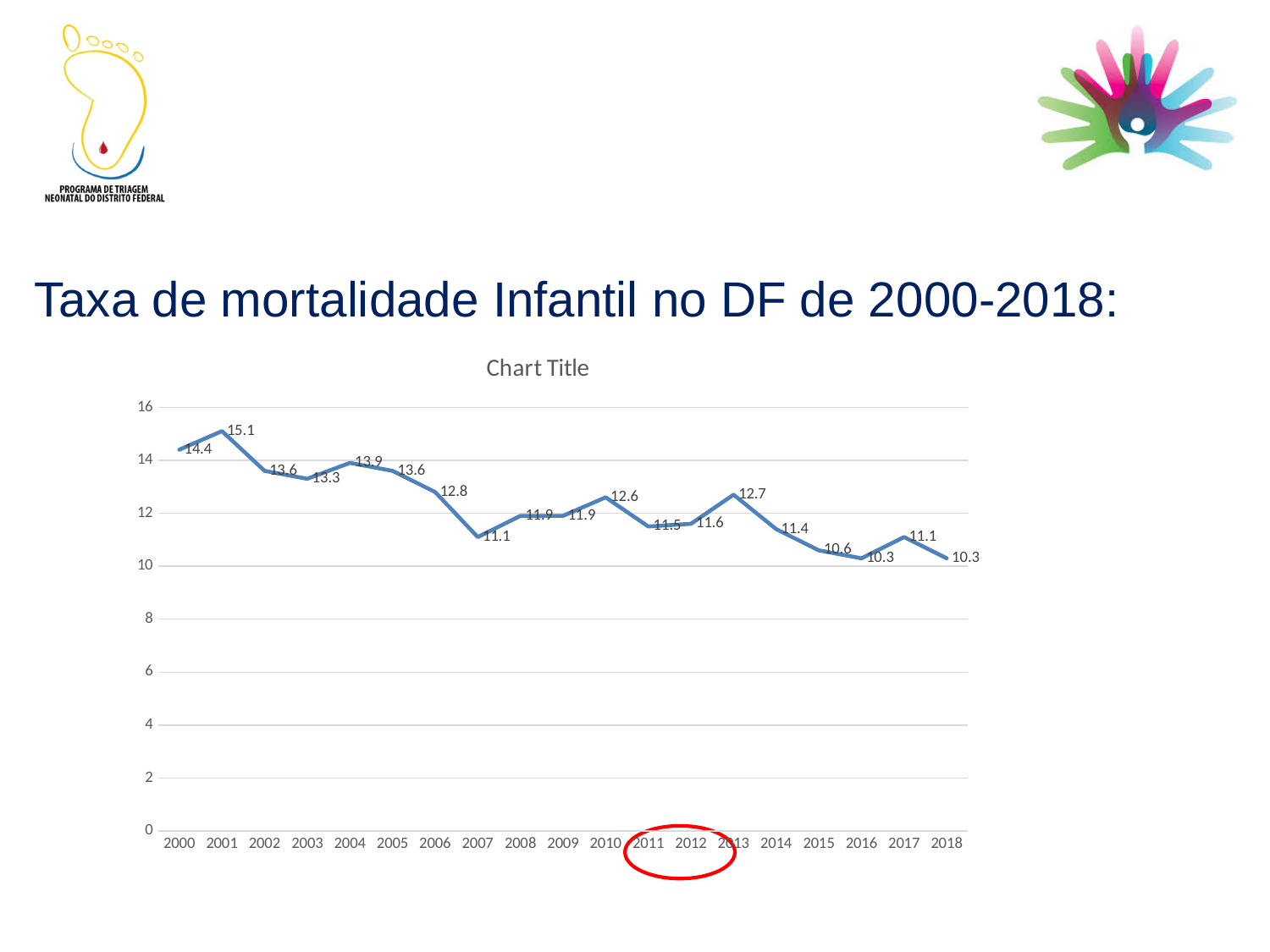
What is the difference between the values for 2000 and 2018? 4.1 Which year has the larger value, 2010 or 2011? 2010 What is the infant mortality rate value plotted for 2001? 15.1 What type of chart is shown on the slide? line chart Overall, do the values rise or fall from 2000 to 2018? fall What is the value plotted for 2007? 11.1 What is the value plotted for 2013? 12.7 What is the title shown above the chart area? Chart Title How many years are plotted on the x axis? 19 What is the lowest value plotted on the chart? 10.3 What is the value plotted for 2018? 10.3 Which year has the highest value on the chart? 2001